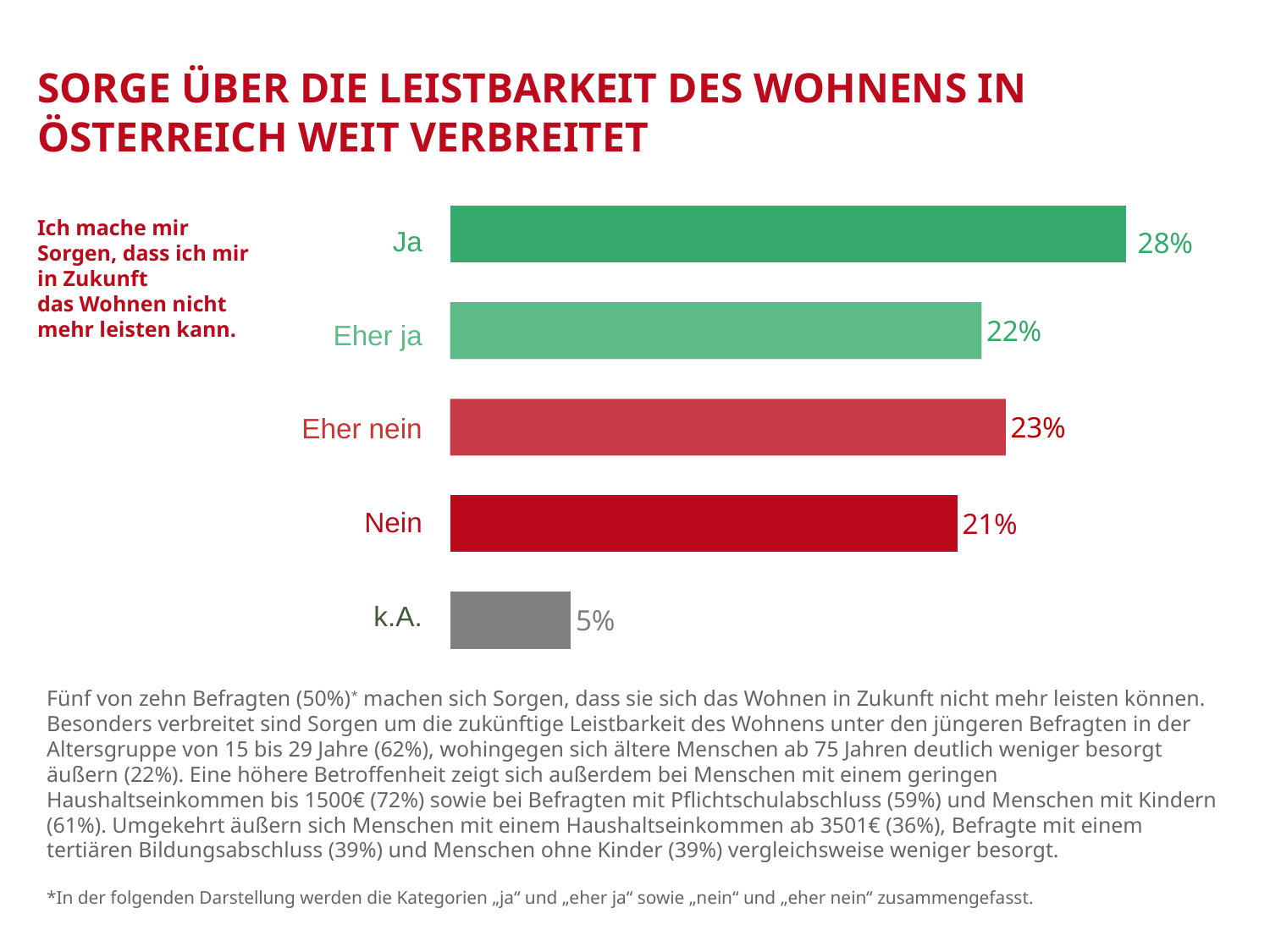
What is the combined value of "Ja" and "Eher ja"? 50% How many categories are shown in the chart? 5 What is the difference between the values for "Ja" and "Nein"? 7% Which category has the lowest value? k.A. What is the value for "Eher nein"? 23% What is the value for "Ja"? 28% What is the difference between the values for "Eher nein" and "Eher ja"? 1% What is the value for "k.A."? 5% Which is larger, the value for "Ja" or the value for "Eher ja"? Ja What kind of chart is shown on the slide? Bar chart Which category has the highest value? Ja What colour is the bar for "k.A."? Grey